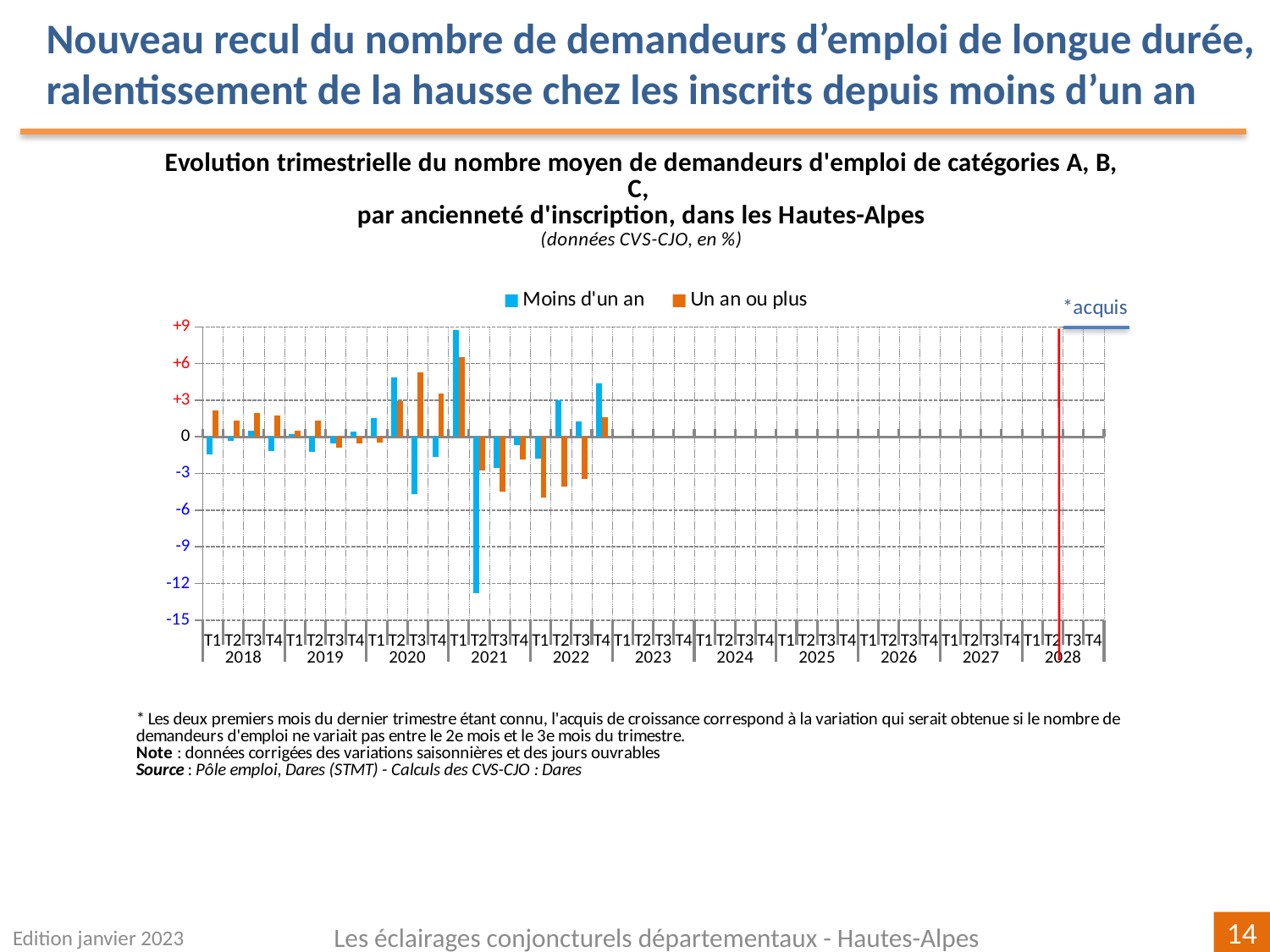
Which series is shown in blue in the legend? Moins d'un an In which quarter does the 'Moins d'un an' series reach its highest value? T1 2021 What kind of chart is shown on the slide? bar chart Is the value for 'Moins d'un an' in T3 2020 greater or less than -3? less In T1 2021, which series has the larger value, 'Moins d'un an' or 'Un an ou plus'? Moins d'un an In which quarter does the 'Moins d'un an' series reach its lowest value? T2 2021 Which series is shown in orange in the legend? Un an ou plus In which quarter does the 'Un an ou plus' series reach its highest value? T1 2021 Is the value for 'Moins d'un an' in T2 2021 greater or less than -9? less Is the value for 'Moins d'un an' in T1 2021 greater or less than +6? greater How many series does the legend list? 2